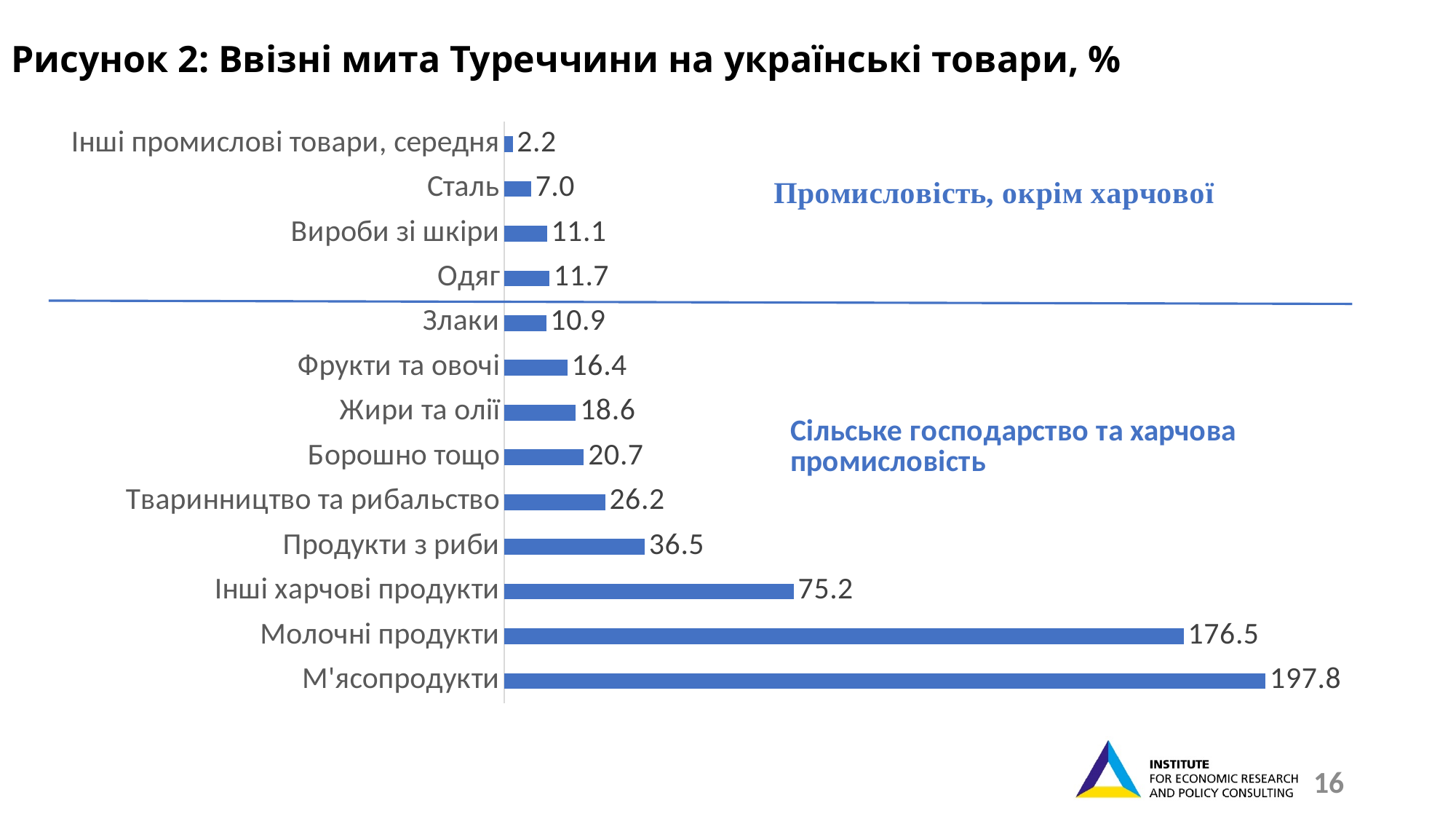
What is the import duty value shown for Молочні продукти? 176.5 What is the value shown for Продукти з риби? 36.5 What kind of chart is shown on the slide? Bar chart What is the difference between the values for М'ясопродукти and Молочні продукти? 21.3 How many categories are plotted on the chart? 13 What is the difference between the values for Інші харчові продукти and Продукти з риби? 38.7 Which has a larger value, Одяг or Злаки? Одяг Which category has the highest value on the chart? М'ясопродукти What is the value shown for Сталь? 7.0 Which has a larger value, Жири та олії or Фрукти та овочі? Жири та олії What is the title of the chart? Рисунок 2: Ввізні мита Туреччини на українські товари, % Which category has the lowest value on the chart? Інші промислові товари, середня